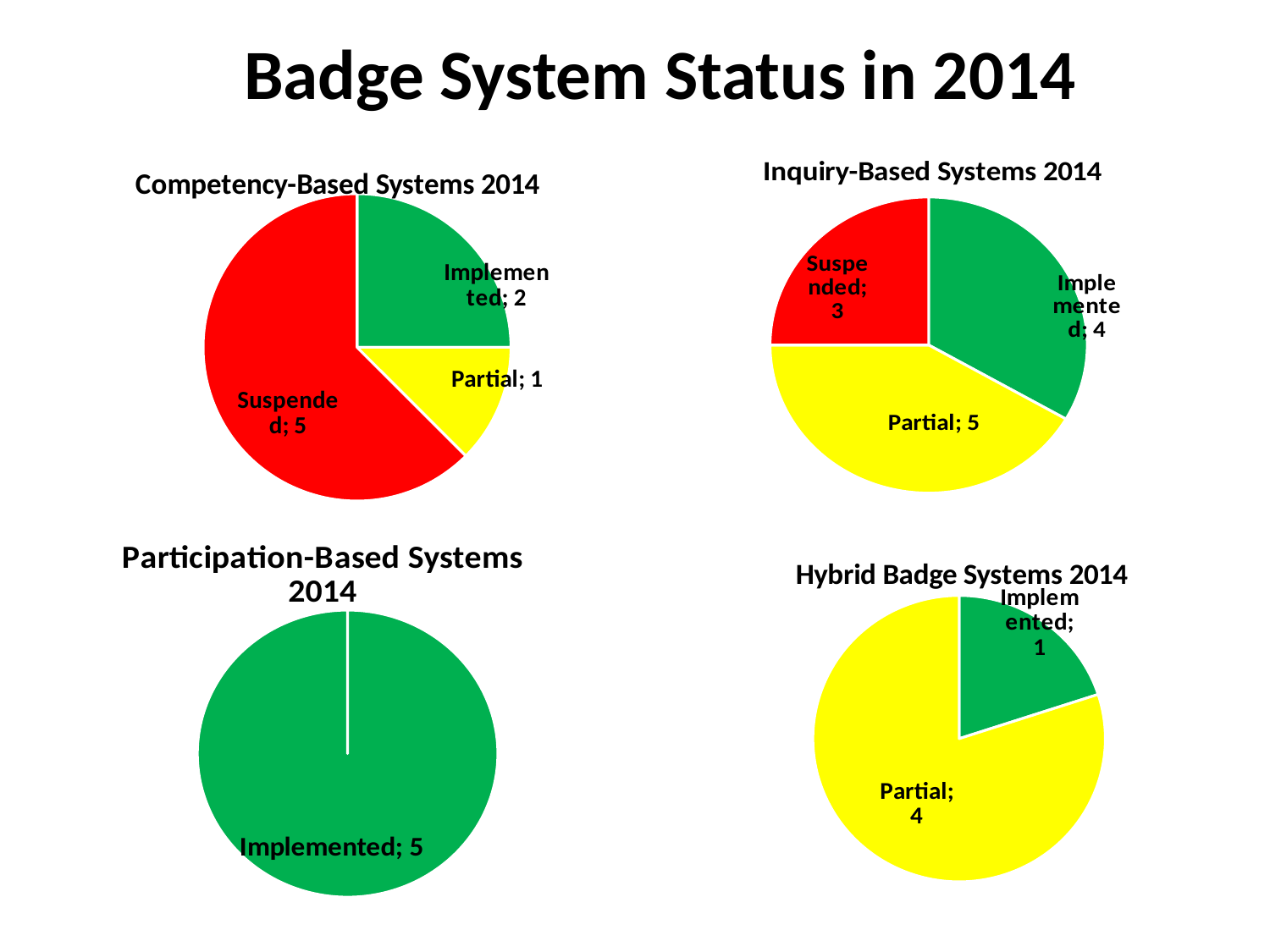
In the Competency-Based Systems 2014 chart, which category has the smallest slice? Partial In the Hybrid Badge Systems 2014 chart, what is the value for Partial? 4 In the Participation-Based Systems 2014 chart, what is the value for Implemented? 5 In the Inquiry-Based Systems 2014 chart, what is the difference between Implemented and Suspended? 1 In the Competency-Based Systems 2014 chart, what is the value for Suspended? 5 What kind of chart is the Competency-Based Systems 2014 chart? Pie chart In the Competency-Based Systems 2014 chart, what share of the pie does Suspended represent? 62.5% In the Inquiry-Based Systems 2014 chart, which category has the largest slice? Partial In the Hybrid Badge Systems 2014 chart, what share of the pie does Implemented represent? 20% In the Inquiry-Based Systems 2014 chart, how many categories are shown? 3 In the Hybrid Badge Systems 2014 chart, which is larger, Implemented or Partial? Partial In the Inquiry-Based Systems 2014 chart, what is the value for Partial? 5